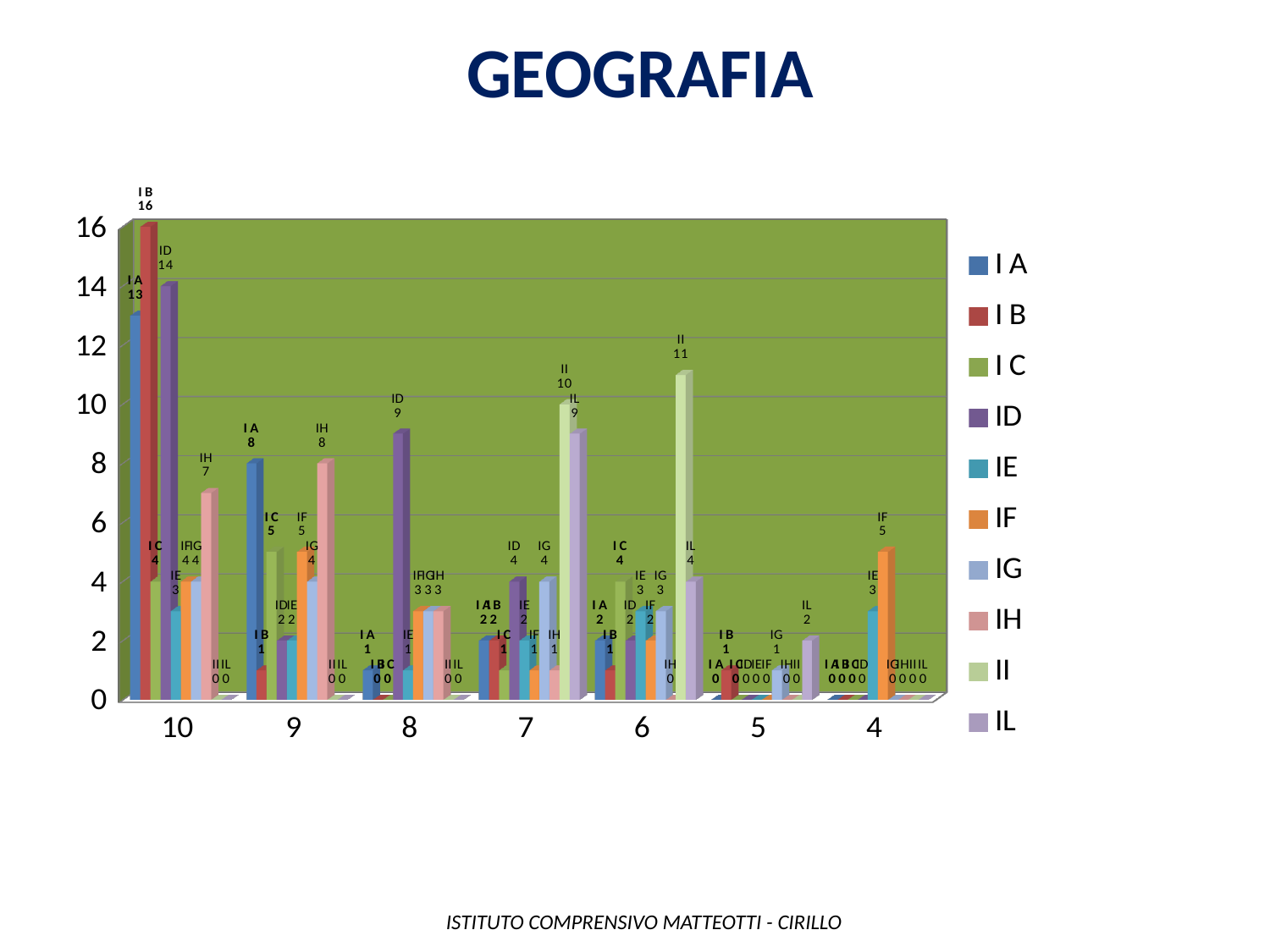
At category 7, which is larger: the value for II or the value for IL? II What is the difference between the values of I B and I A at category 10? 3 How many categories are shown on the x axis? 7 What is the title of the chart? GEOGRAFIA Which series has the highest value at category 8? ID How many series does the legend list? 10 What is the value for series IF at category 4? 5 What is the value for series I B at category 10? 16 Which series has the highest value at category 10? I B What is the value for series ID at category 10? 14 What is the value for series II at category 6? 11 What kind of chart is shown on the slide? bar chart